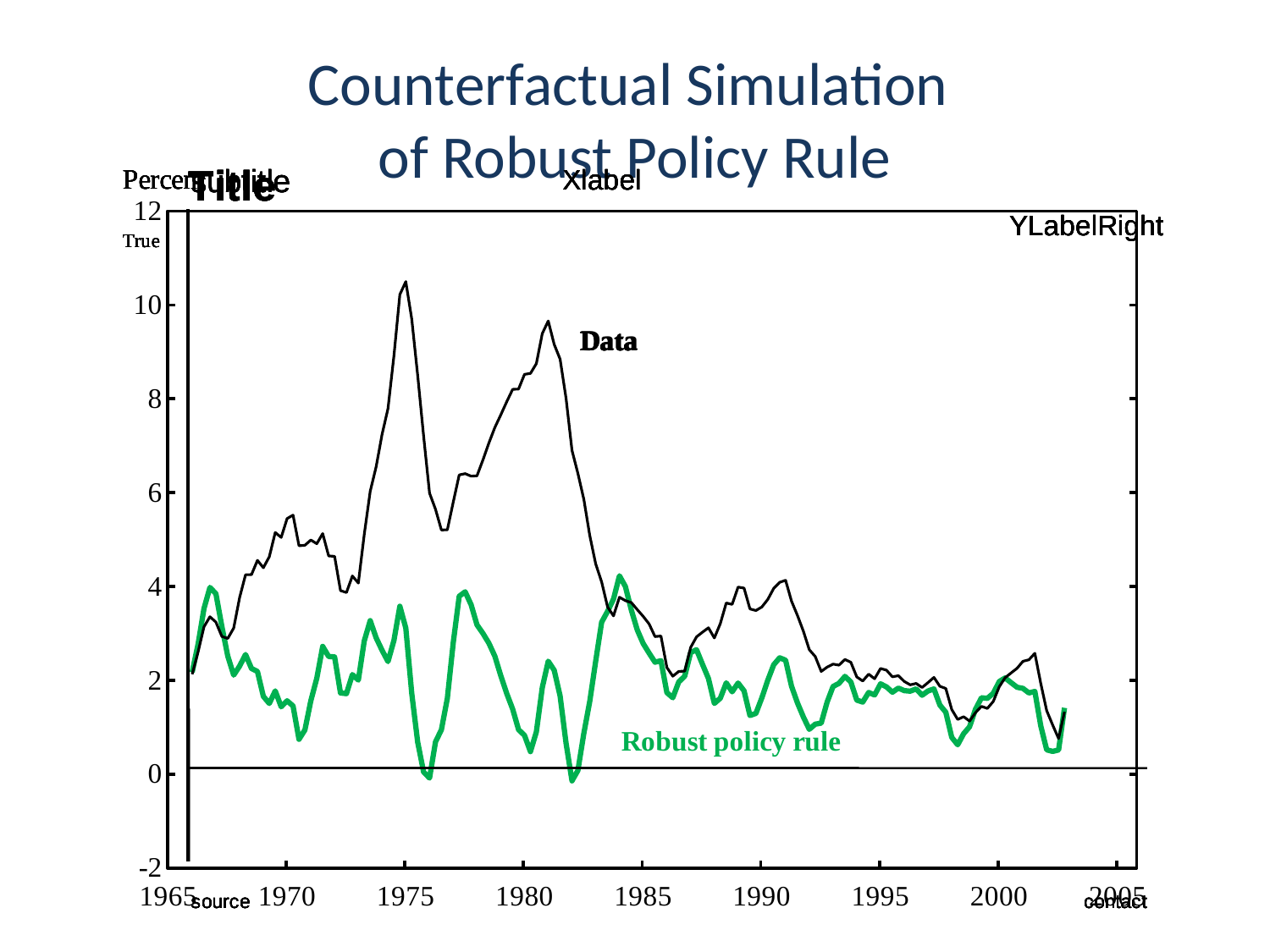
Around 1975, which series has the higher value, Data or Robust policy rule? Data Is the peak value of the Robust policy rule series around 1984 greater or less than 6? less Is the value of the Data series around 1990 greater or less than 6? less What colour is the Robust policy rule line? green What is the title of the slide? Counterfactual Simulation of Robust Policy Rule What kind of chart is shown on the slide? line chart Does the Data series rise or fall between 1981 and 1985? fall Is the peak value of the Data series around 1981 greater or less than 8? greater How many data series are plotted on the chart? 2 Which series reaches the highest value on the chart? Data